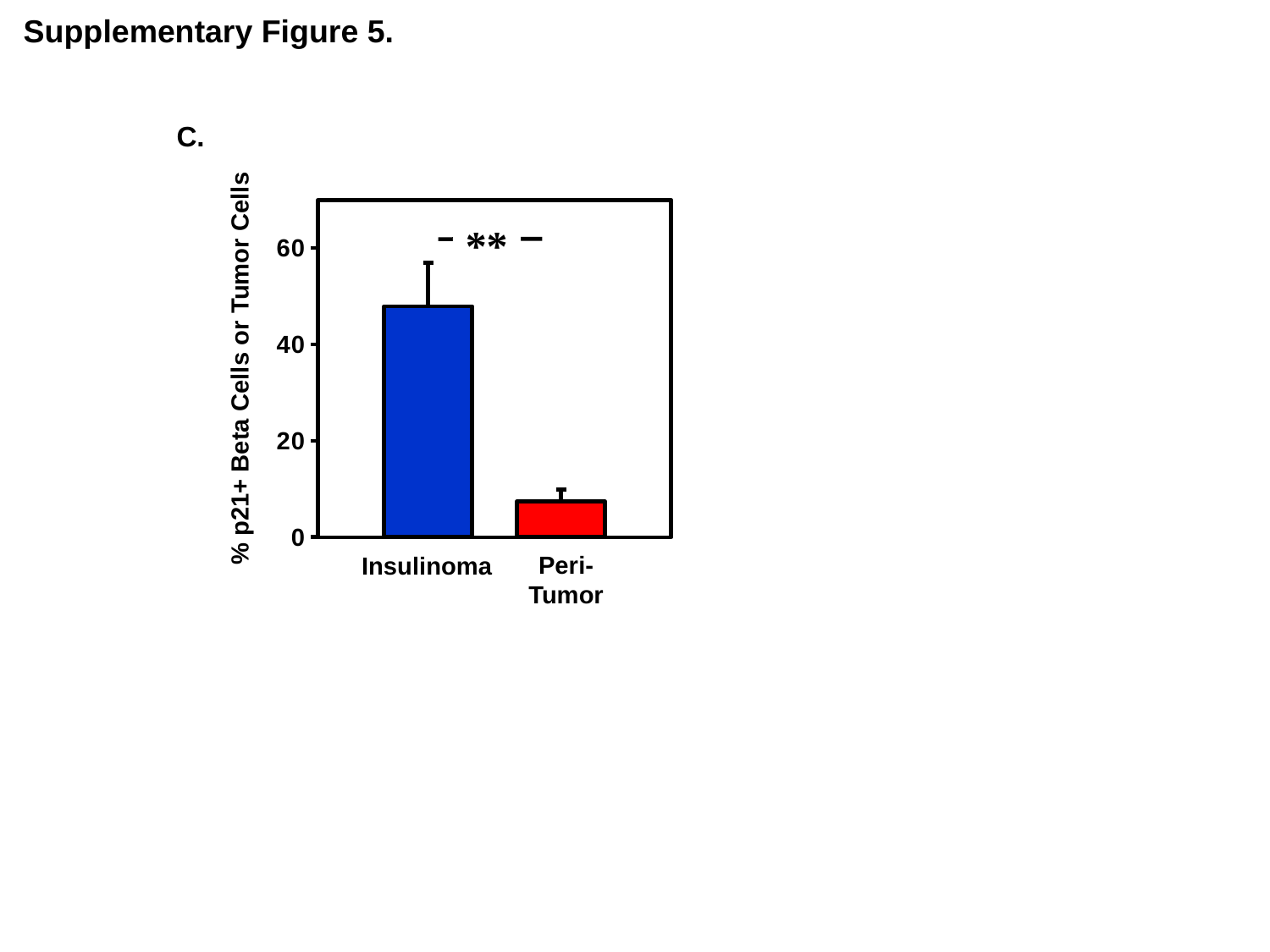
How many categories are plotted on the x axis? 2 Is the value for Insulinoma greater or less than 60? less Which category has the lowest value? Peri-Tumor Which is larger, the value for Insulinoma or the value for Peri-Tumor? Insulinoma What is the label of the y axis? % p21+ Beta Cells or Tumor Cells Do the values rise or fall from Insulinoma to Peri-Tumor along the x axis? fall Which category has the highest value? Insulinoma Is the value for Insulinoma greater or less than 40? greater What kind of chart is shown on the slide? bar chart Is the value for Peri-Tumor greater or less than 20? less What colour is the bar for Insulinoma? blue